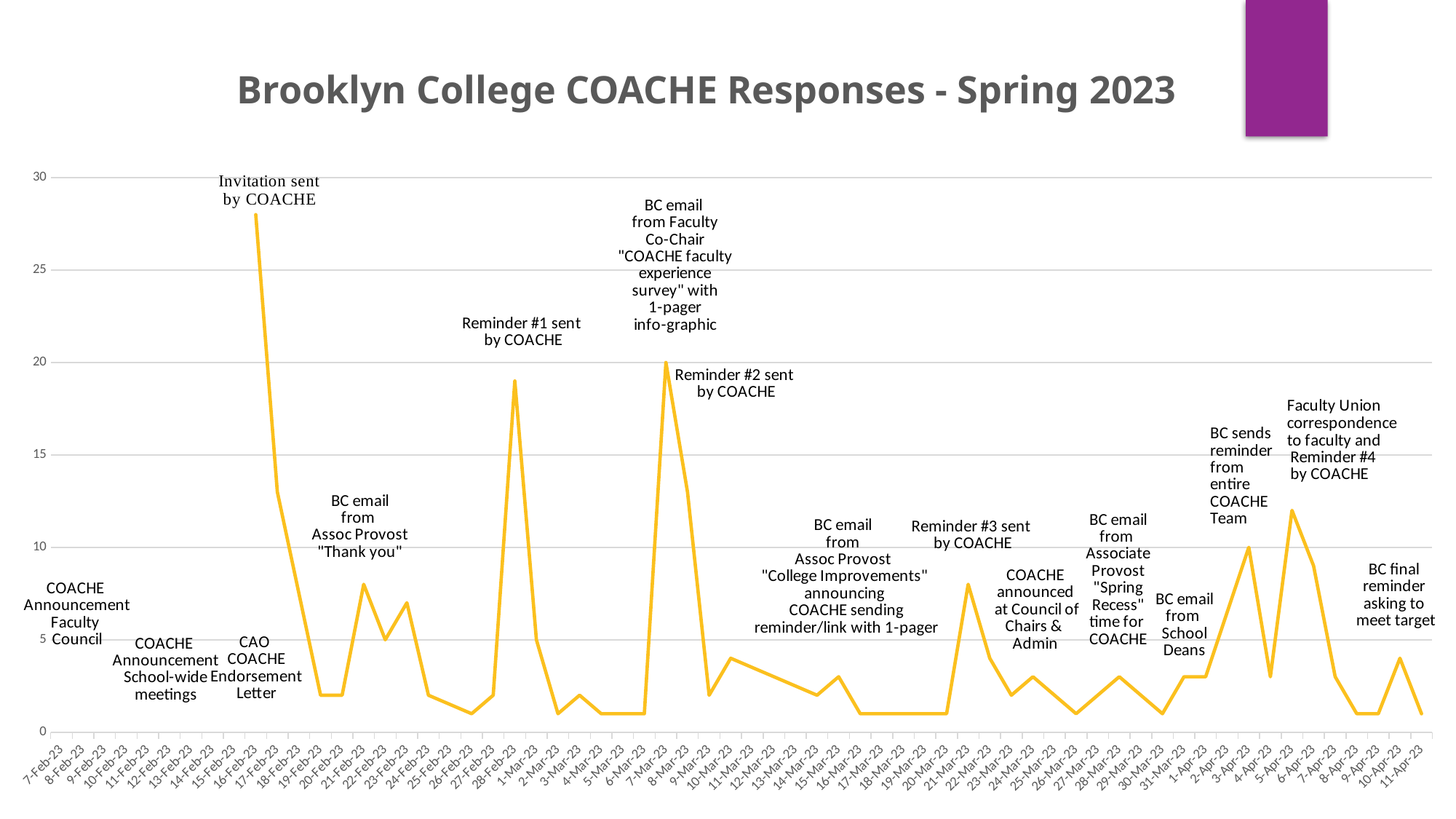
Is the value for 21-Mar-23 greater or less than 10? less Is the value for 21-Feb-23 greater or less than 10? less Is the value for 28-Feb-23 greater or less than 15? greater What is the title of the chart? Brooklyn College COACHE Responses - Spring 2023 Which date has the larger value, 16-Feb-23 or 8-Mar-23? 16-Feb-23 Which date has the larger value, 28-Feb-23 or 5-Apr-23? 28-Feb-23 Does the line rise or fall between 16-Feb-23 and 19-Feb-23? fall What kind of chart is shown on the slide? line chart On which date does the line reach its highest value? 16-Feb-23